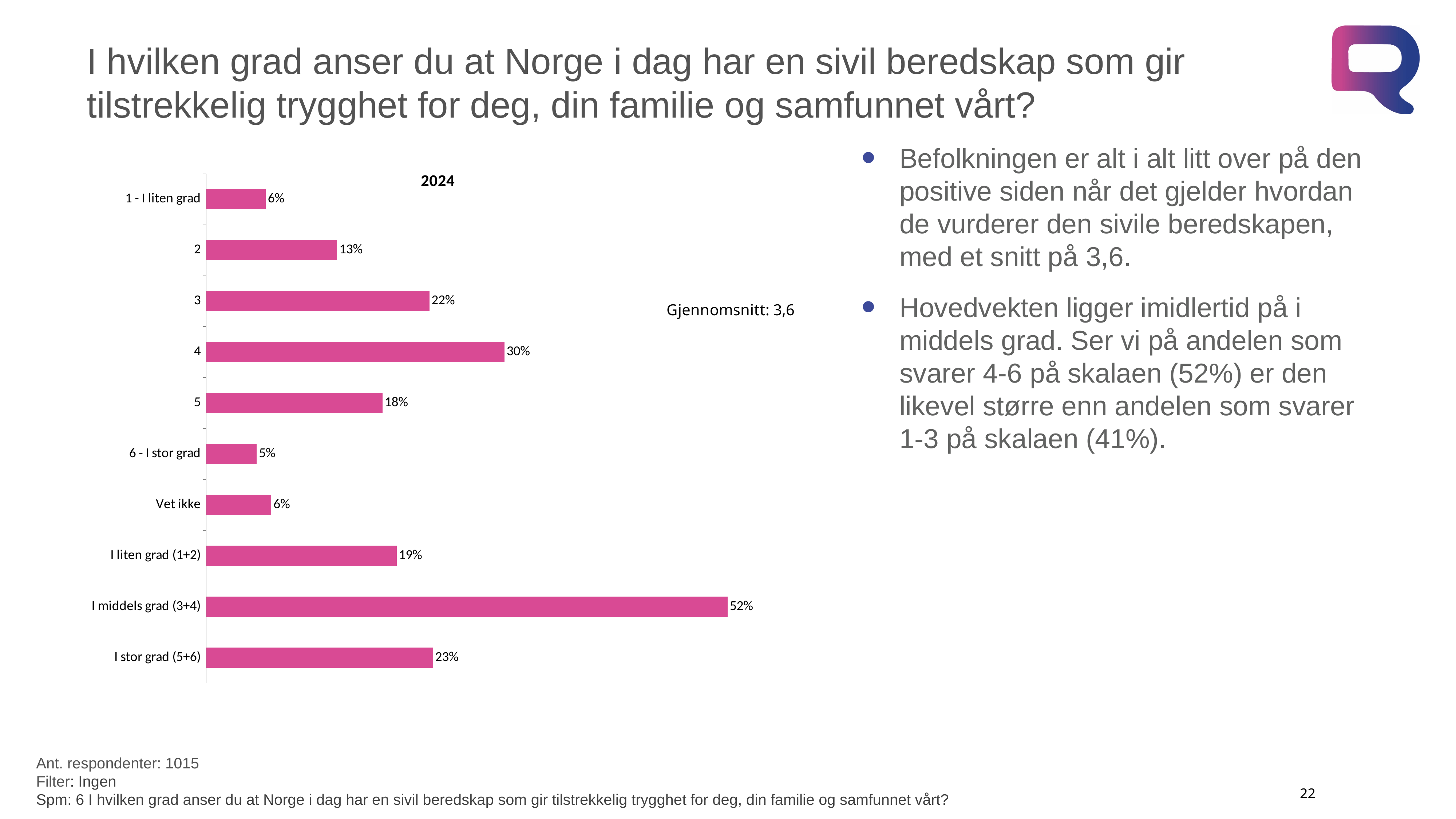
What is the difference between the values for "I stor grad (5+6)" and "I liten grad (1+2)"? 4% Which category has the highest value in the chart? I middels grad (3+4) What kind of chart is shown on the slide? Bar chart What is the value for "I middels grad (3+4)" in the chart? 52% What is the difference between the values for "4" and "2"? 17% What is the value for "Vet ikke" in the chart? 6% What is the value for "4" in the chart? 30% Which category has the lowest value in the chart? 6 - I stor grad Which is larger, the value for "3" or the value for "5"? 3 What average (Gjennomsnitt) is shown next to the chart? 3,6 What is the value for "6 - I stor grad" in the chart? 5% How many categories are shown in the chart? 10